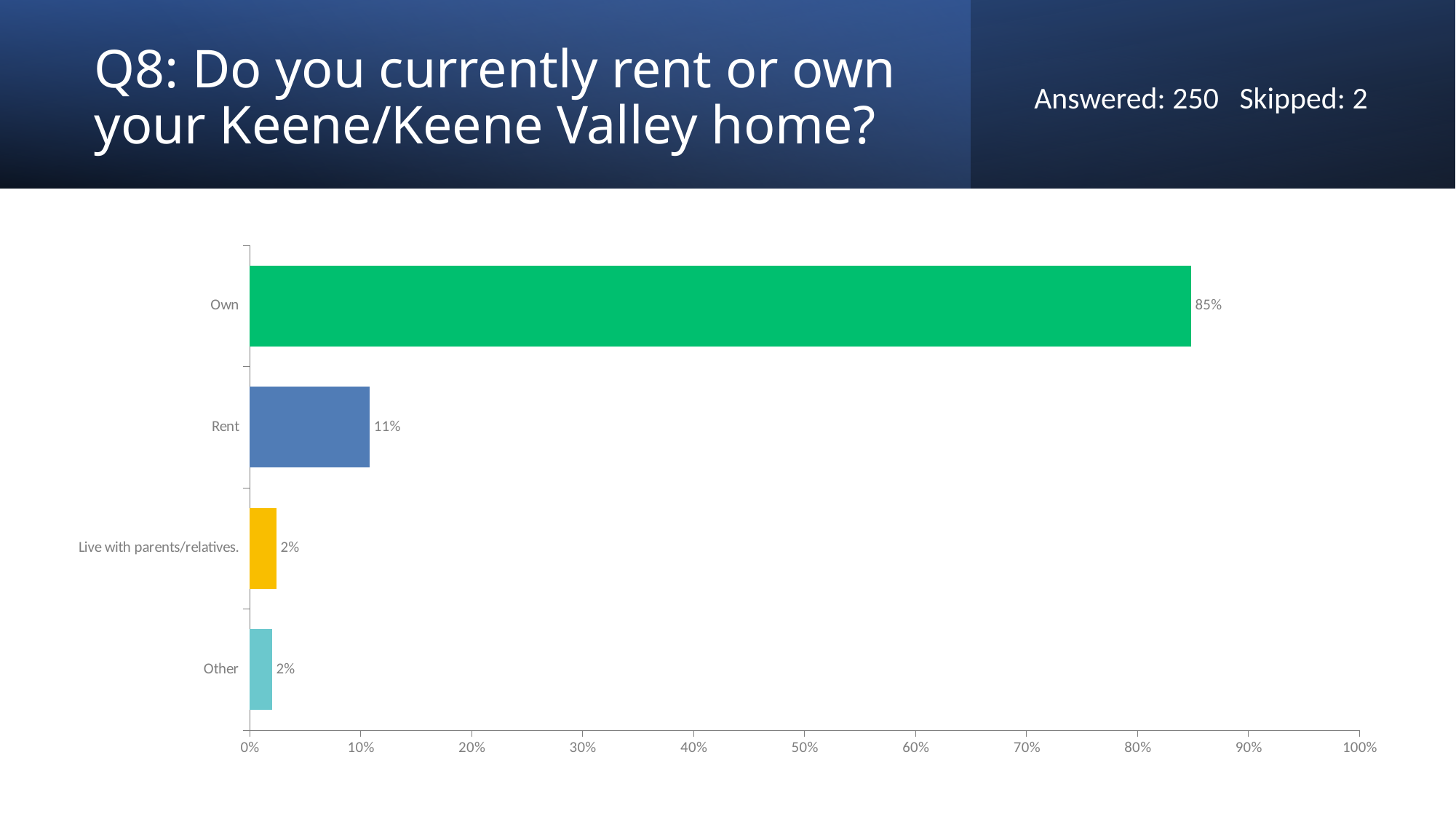
Is the value for Rent greater or less than 20%? less Is the value for Own greater or less than 80%? greater How many categories are shown in the chart? 4 What kind of chart is shown on the slide? bar chart How many respondents answered this question according to the slide? 250 What is the value for the 'Other' category? 2% What is the value for 'Live with parents/relatives.'? 2% What percentage of respondents rent their home? 11% Which is larger, the value for Rent or the value for Other? Rent What percentage of respondents own their Keene/Keene Valley home? 85% What is the difference between the Own and Rent percentages? 74% Which category has the highest value? Own